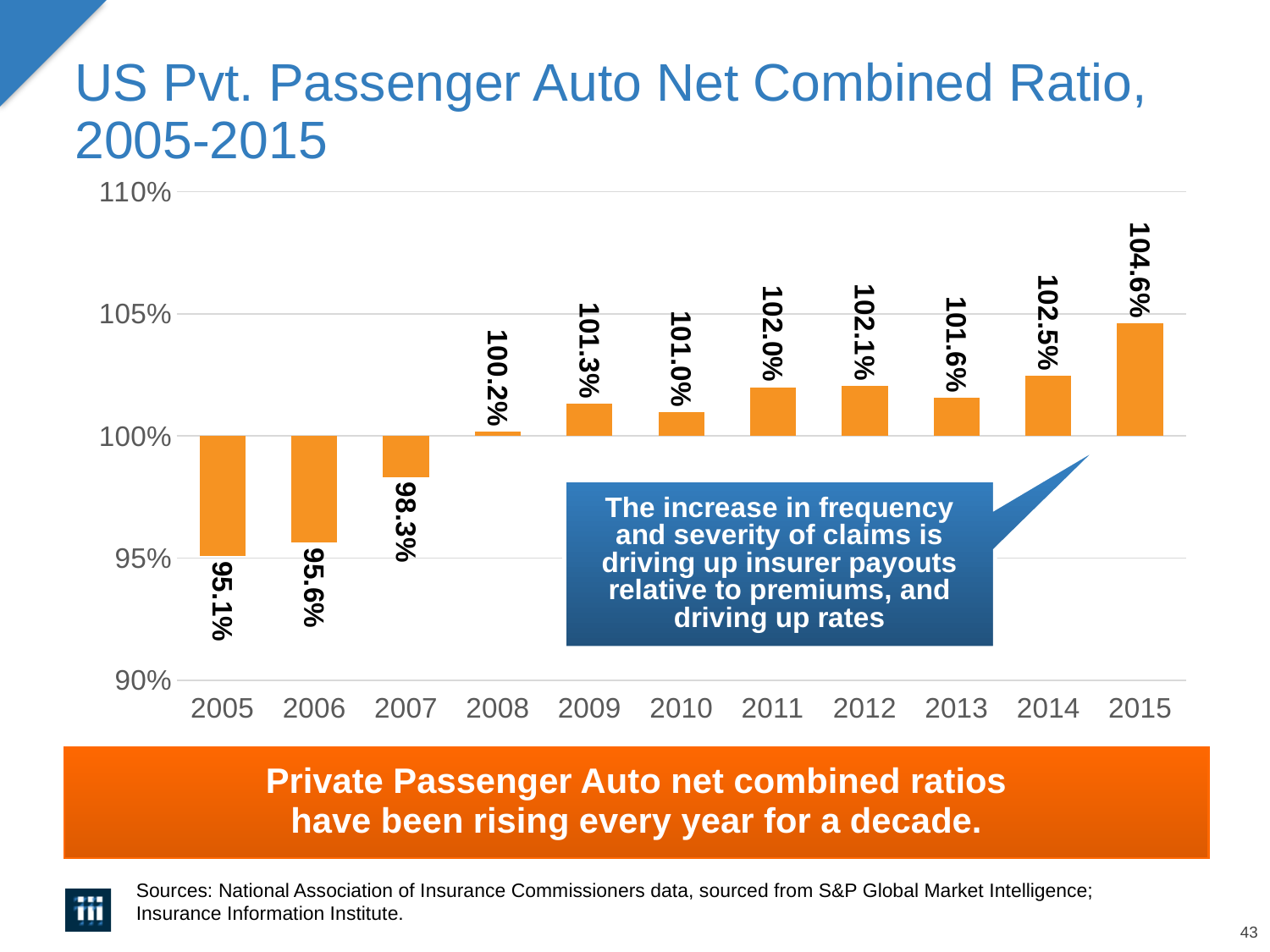
Which year has the lowest net combined ratio? 2005 What is the net combined ratio for 2010? 101.0% What is the net combined ratio for 2015? 104.6% Is the value for 2007 greater or less than 100%? less What is the net combined ratio for 2005? 95.1% How many years are shown on the x axis? 11 Which year has the highest net combined ratio? 2015 Do the net combined ratios generally rise or fall from 2005 to 2015? Rise Which year has a higher net combined ratio, 2012 or 2013? 2012 What is the title of the chart? US Pvt. Passenger Auto Net Combined Ratio, 2005-2015 What is the difference between the 2015 and 2005 net combined ratios? 9.5 percentage points What kind of chart is shown on the slide? Bar chart